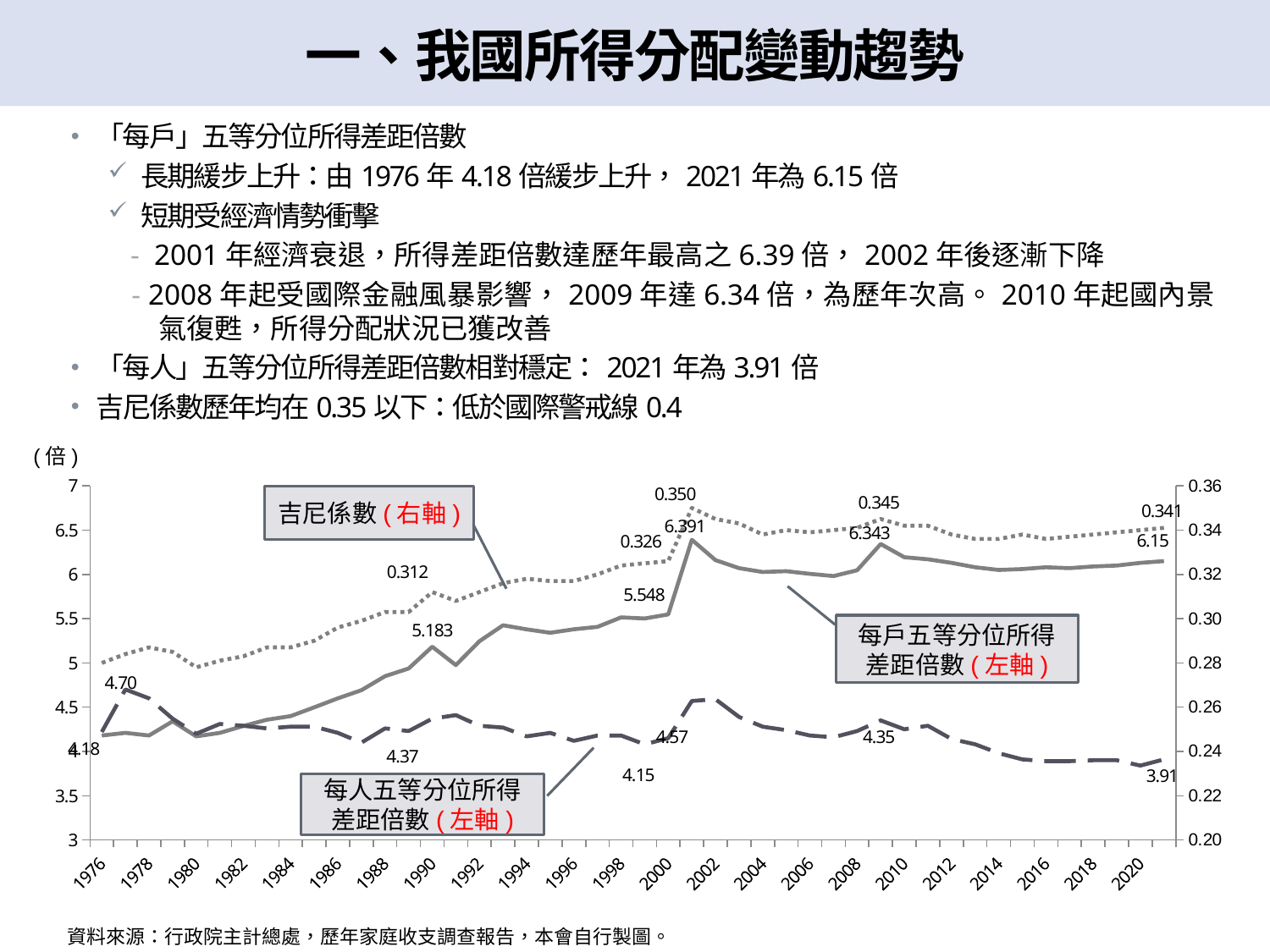
How many data series are plotted in the chart? 3 What is the difference between the 每戶五等分位所得差距倍數 labels 6.391 and 6.343? 0.048 Does the 每戶五等分位所得差距倍數 line generally rise or fall from 1976 to 2001? rise Which axis is the 吉尼係數 series plotted against? 右軸 (right axis) What is the labelled value of 每人五等分位所得差距倍數 at the end of the series (2021)? 3.91 What kind of chart is shown on the slide? line chart What is the labelled value of 每戶五等分位所得差距倍數 in 2001? 6.391 What is the labelled value of 每戶五等分位所得差距倍數 in 2009? 6.343 Which is larger, the 每戶五等分位所得差距倍數 label 5.183 or 5.548? 5.548 Is the 吉尼係數 value in 2021 greater or less than 0.36? less What is the highest labelled value of 吉尼係數 on the chart? 0.350 What is the difference between the 2021 labels for 每戶 (6.15) and 每人 (3.91) 五等分位所得差距倍數? 2.24